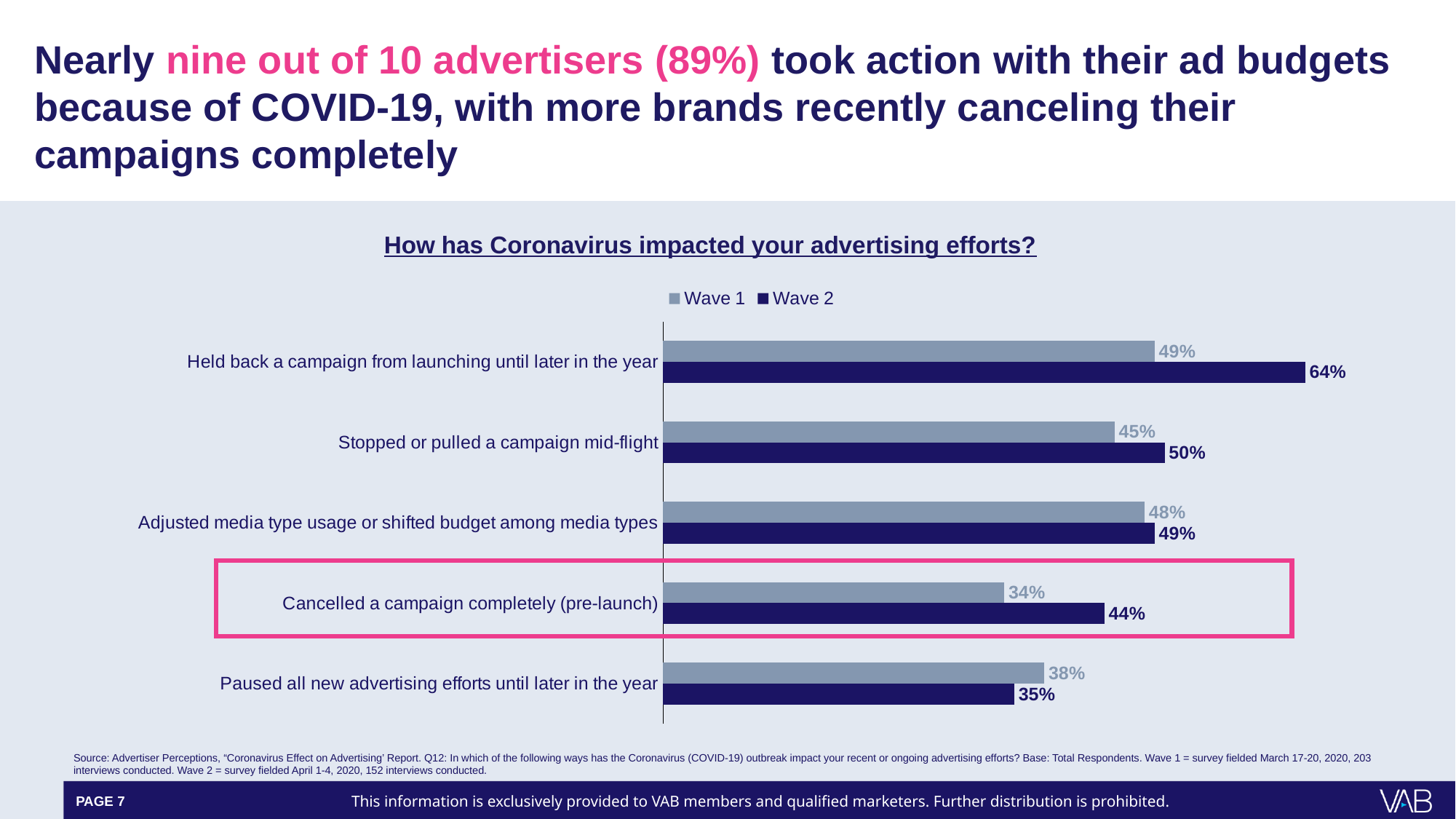
Which category has the lowest Wave 1 value? Cancelled a campaign completely (pre-launch) What is the difference between the Wave 2 and Wave 1 values for 'Cancelled a campaign completely (pre-launch)'? 10% Which category is highlighted with a pink box on the chart? Cancelled a campaign completely (pre-launch) What is the difference between the Wave 2 and Wave 1 values for 'Held back a campaign from launching until later in the year'? 15% How many categories are shown in the chart? 5 What is the Wave 2 value for 'Held back a campaign from launching until later in the year'? 64% What kind of chart is shown on the slide? Bar chart How many series does the legend list? 2 Which category has the highest Wave 2 value? Held back a campaign from launching until later in the year For 'Paused all new advertising efforts until later in the year', which is larger: the Wave 1 value or the Wave 2 value? Wave 1 What is the Wave 1 value for 'Cancelled a campaign completely (pre-launch)'? 34% What is the Wave 1 value for 'Paused all new advertising efforts until later in the year'? 38%